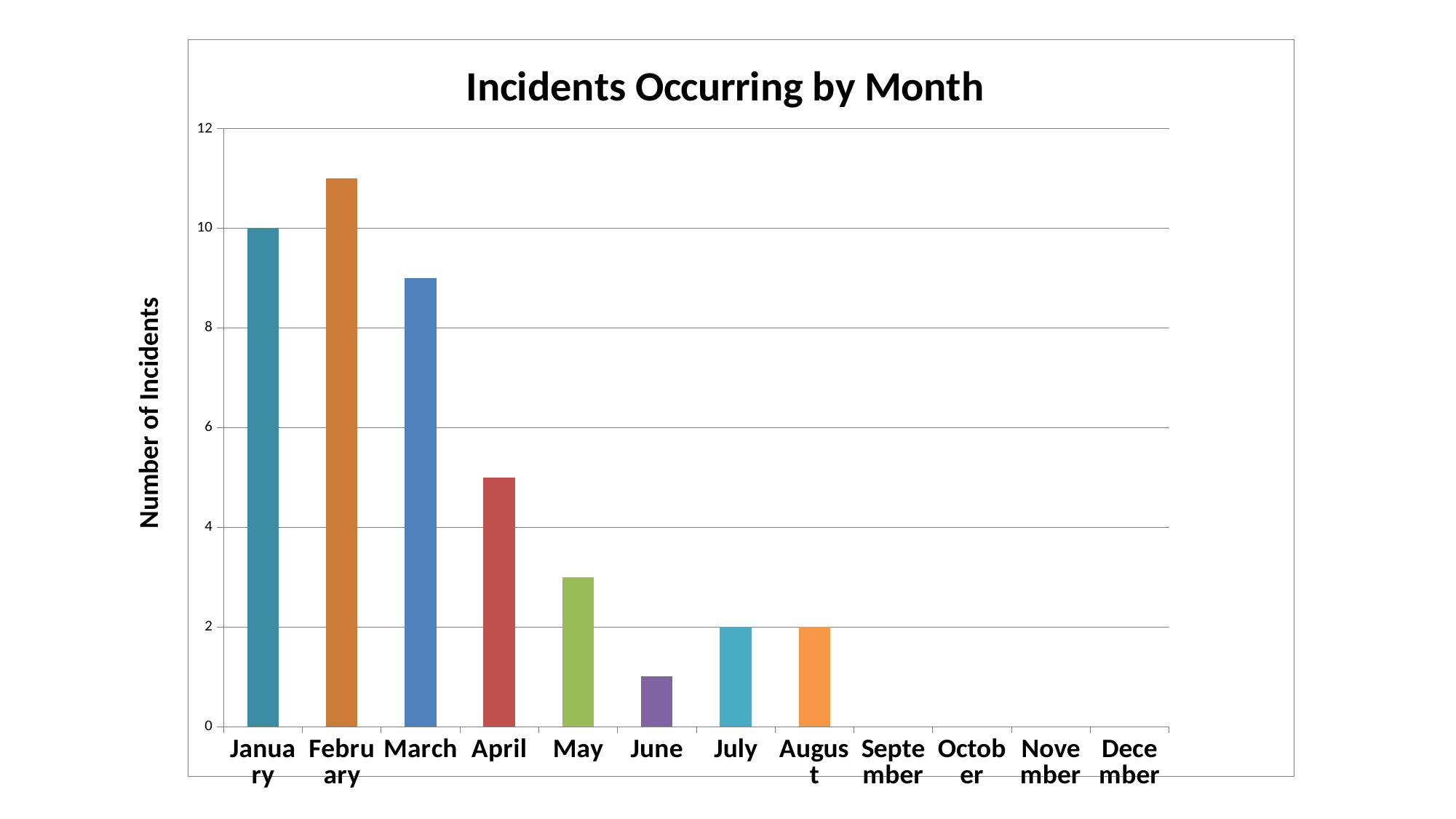
What is the number of incidents for January? 10 Is the value for April greater or less than 4? greater What is the difference between the number of incidents in January and in July? 8 How many months are shown on the x axis? 12 What kind of chart is shown on the slide? Bar chart Is the value for February greater or less than 10? greater What is the number of incidents for July? 2 Which month has the highest number of incidents? February Among the months January through August, which has the lowest number of incidents? June Is the value for May greater or less than 4? less Which is larger, the value for March or the value for April? March